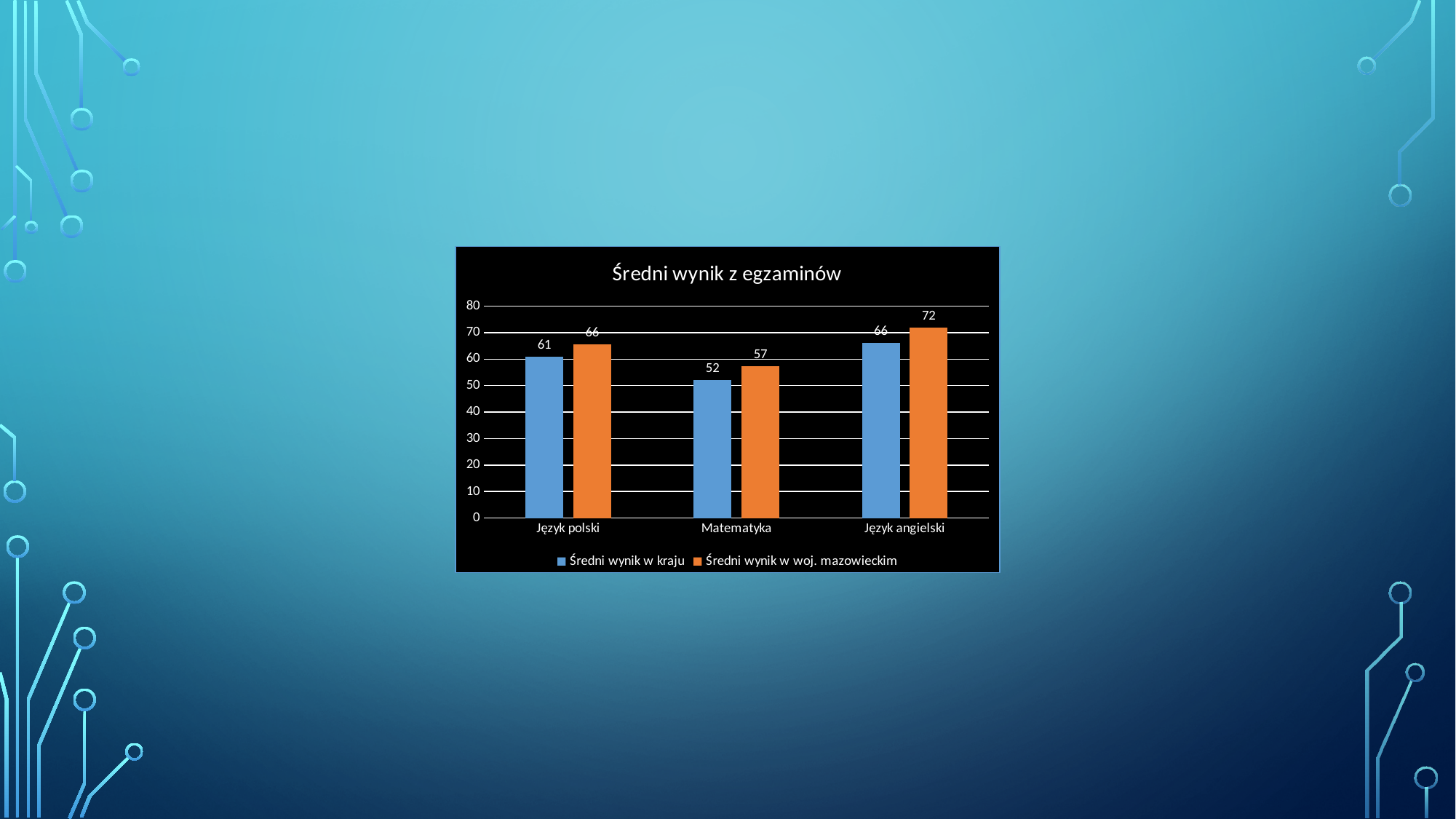
How many categories are shown on the x axis? 3 What kind of chart is shown on the slide? bar chart Which category has the lowest value in the Średni wynik w kraju series? Matematyka What is the value for Język angielski in the Średni wynik w kraju series? 66 Which category has the highest value in the Średni wynik w woj. mazowieckim series? Język angielski Which is larger for Matematyka: Średni wynik w kraju or Średni wynik w woj. mazowieckim? Średni wynik w woj. mazowieckim What is the value for Matematyka in the Średni wynik w woj. mazowieckim series? 57 How many series does the legend list? 2 What is the title of the chart? Średni wynik z egzaminów Is the value for Język polski in the Średni wynik w woj. mazowieckim series greater or less than 60? greater What is the difference between the Średni wynik w woj. mazowieckim and Średni wynik w kraju values for Język angielski? 6 What is the value for Język polski in the Średni wynik w kraju series? 61